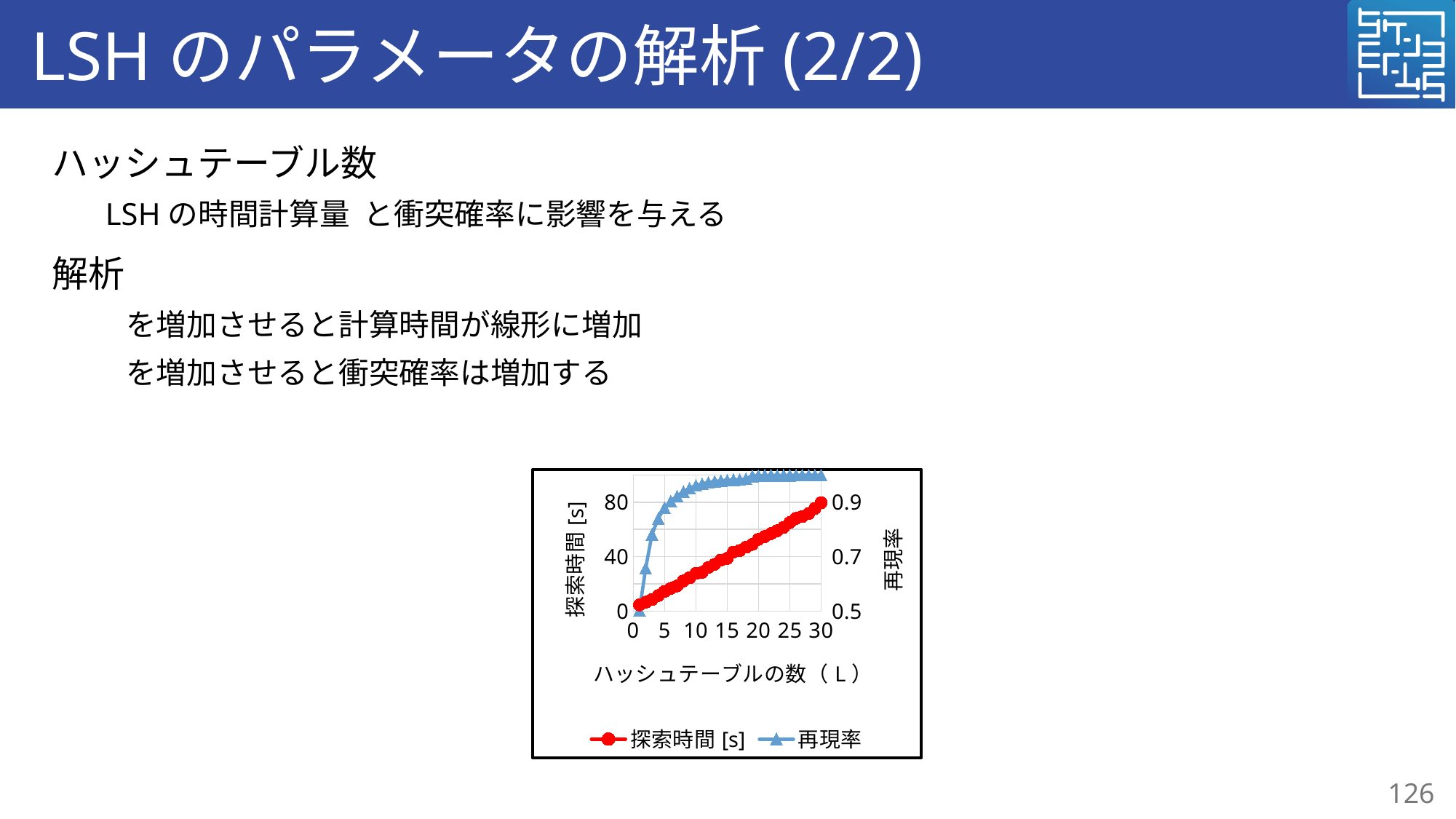
Is the 探索時間 [s] value at L = 10 greater or less than 40? less Does the 探索時間 [s] series rise or fall as the number of hash tables (L) increases? rise What is the x-axis title of the chart? ハッシュテーブルの数（L） Does the 再現率 series rise or fall as the number of hash tables (L) increases? rise Is the 再現率 value at L = 30 greater or less than 0.9? greater How many series does the chart legend list? 2 Is the 探索時間 [s] value at L = 5 greater or less than 40? less What are the two series listed in the chart legend? 探索時間 [s] and 再現率 What kind of chart is shown on the slide? line chart